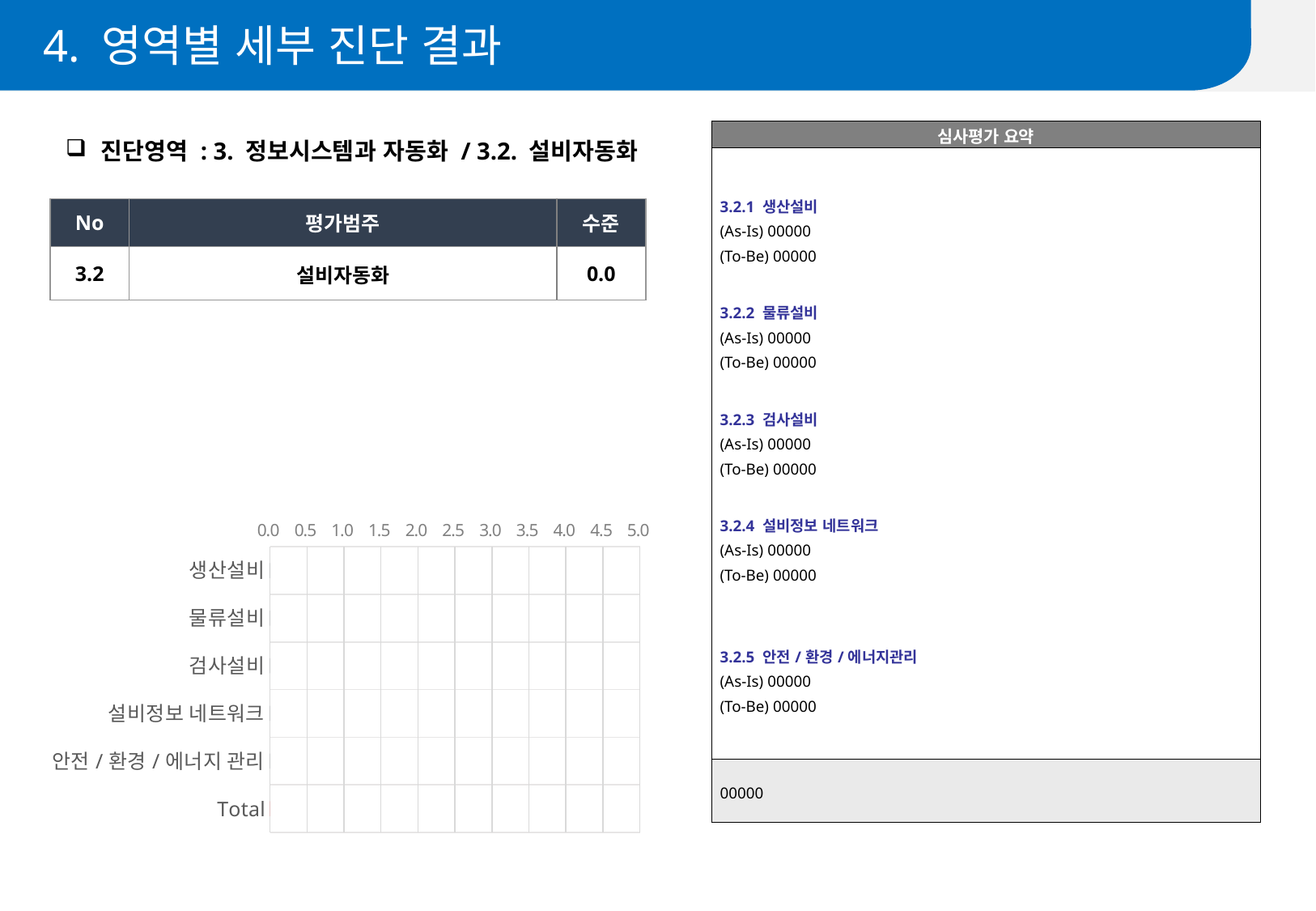
What is the label of the last category at the bottom of the chart? Total What is the label of the first category at the top of the chart? 생산설비 What is the lowest value shown on the chart's horizontal axis? 0.0 How many categories are listed on the vertical axis of the chart? 6 Are any bars plotted in the chart? No What is the highest value shown on the chart's horizontal axis? 5.0